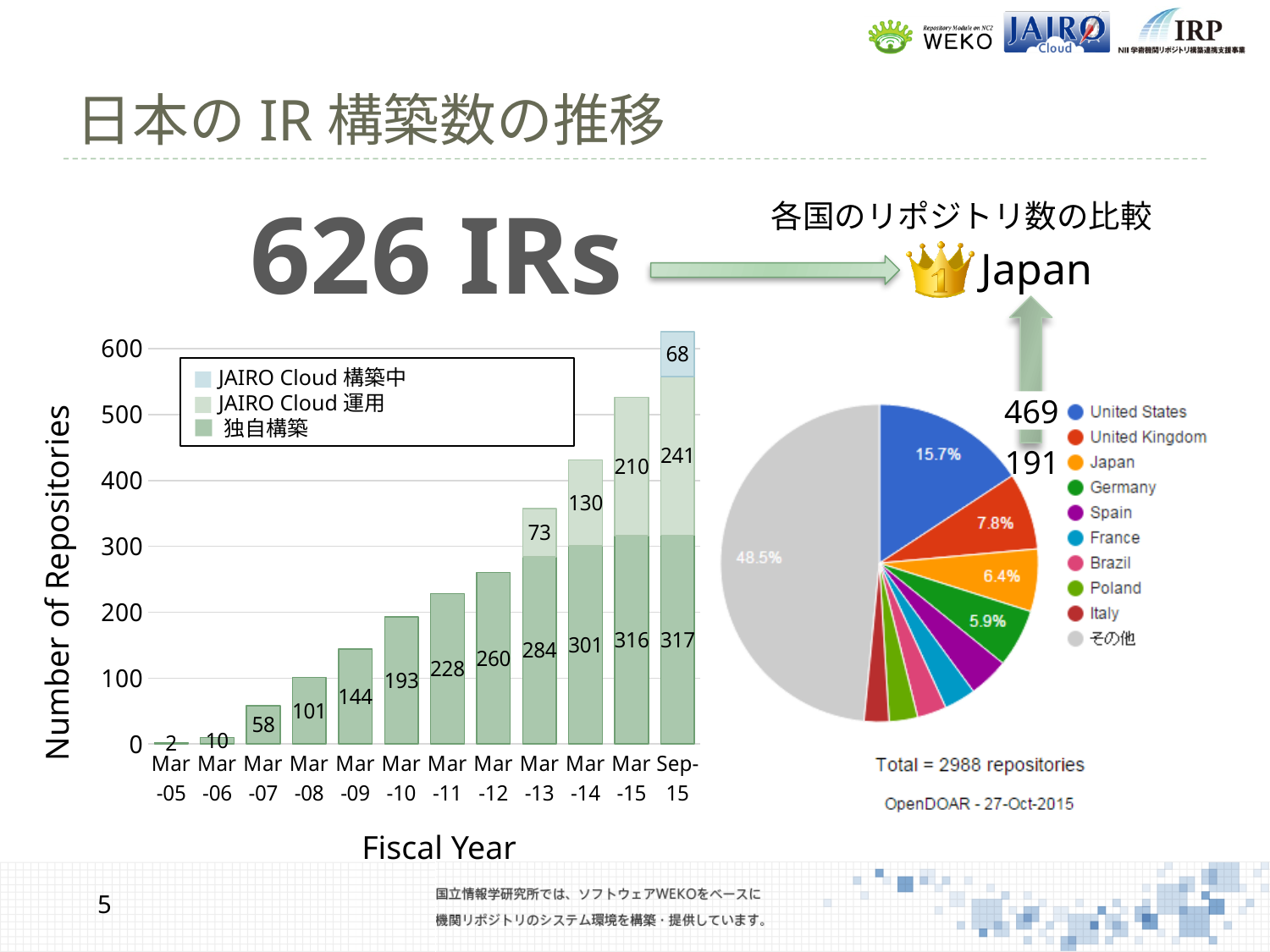
In the bar chart on the left, do the 独自構築 values rise or fall from Mar-05 to Sep-15? rise In the bar chart on the left, what is the value of JAIRO Cloud 運用 for Mar-14? 130 In the bar chart on the left, how many fiscal year categories are shown on the x axis? 12 In the pie chart on the right, what share does United States have? 15.7% In the bar chart on the left, what is the value of 独自構築 for Mar-15? 316 In the bar chart on the left, what is the value of JAIRO Cloud 構築中 for Sep-15? 68 In the bar chart on the left, what is the total of the stacked bar for Sep-15? 626 In the pie chart on the right, which is larger, the share for United Kingdom or the share for Japan? United Kingdom In the bar chart on the left, what is the difference between the 独自構築 values for Mar-10 and Mar-09? 49 In the pie chart on the right, how many entries does the legend list? 10 In the bar chart on the left, what is the total of the stacked bar for Mar-15? 526 In the bar chart on the left, how many series does the legend list? 3